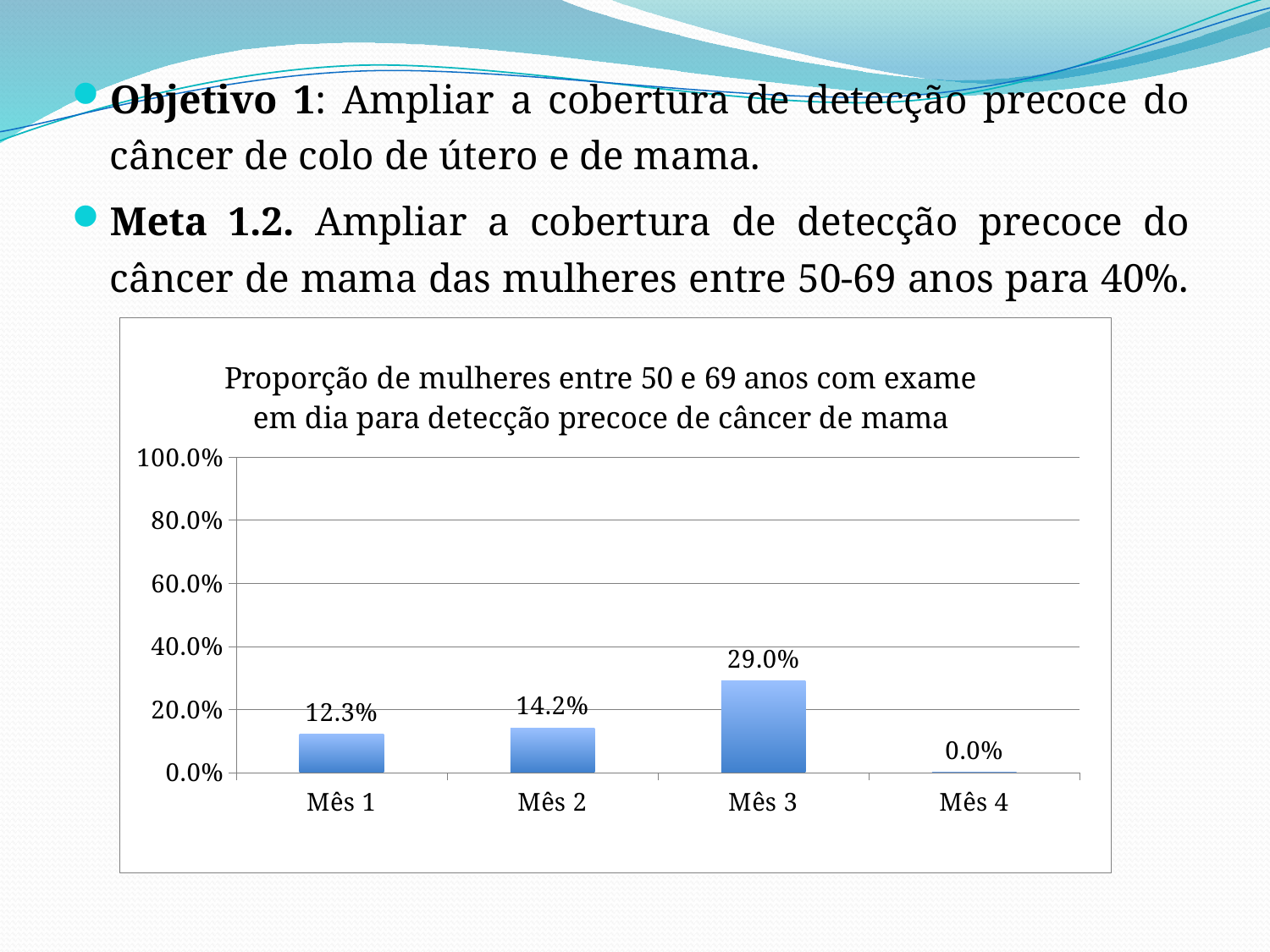
What kind of chart is shown on the slide? bar chart Which is larger, the value for Mês 1 or the value for Mês 2? Mês 2 What is the value for Mês 4? 0.0% Which month has the highest value? Mês 3 What is the title of the chart? Proporção de mulheres entre 50 e 69 anos com exame em dia para detecção precoce de câncer de mama How many months are shown on the x axis? 4 What is the value for Mês 3? 29.0% What is the difference between the values for Mês 3 and Mês 2? 14.8% What is the value for Mês 1? 12.3% Which month has the lowest value? Mês 4 Do the values rise or fall from Mês 1 to Mês 3? rise Is the value for Mês 3 greater or less than 20.0%? greater